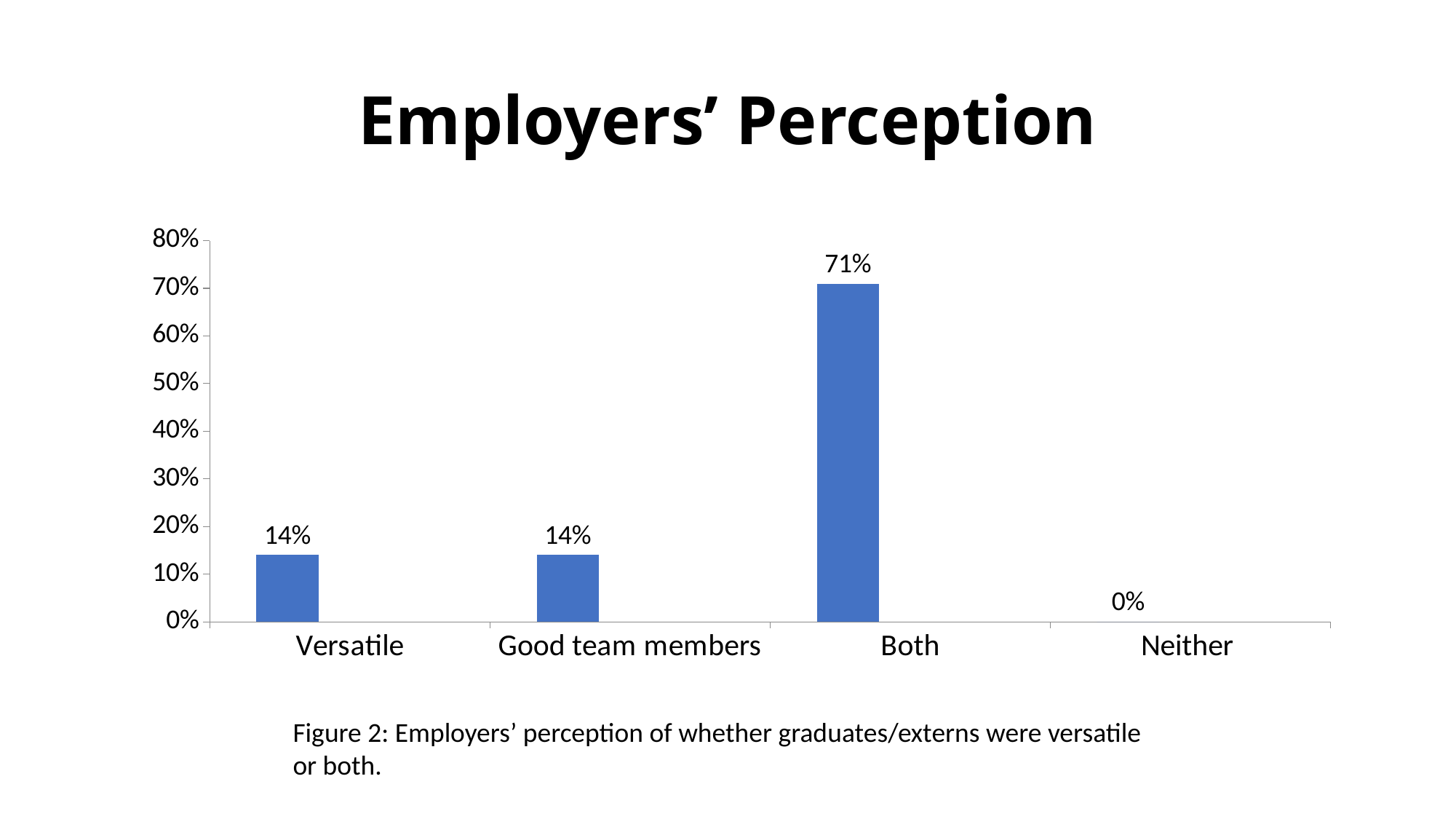
What is the difference between the values for Both and Versatile? 57% Which category has the highest value? Both What is the title of the slide? Employers' Perception What is the value for Good team members? 14% Which is larger, the value for Both or the value for Good team members? Both What is the value for Versatile? 14% Which category has the lowest value? Neither What is the value for Both? 71% What is the value for Neither? 0% What kind of chart is shown on the slide? bar chart How many categories are shown on the x axis? 4 Is the value for Both greater or less than 60%? greater